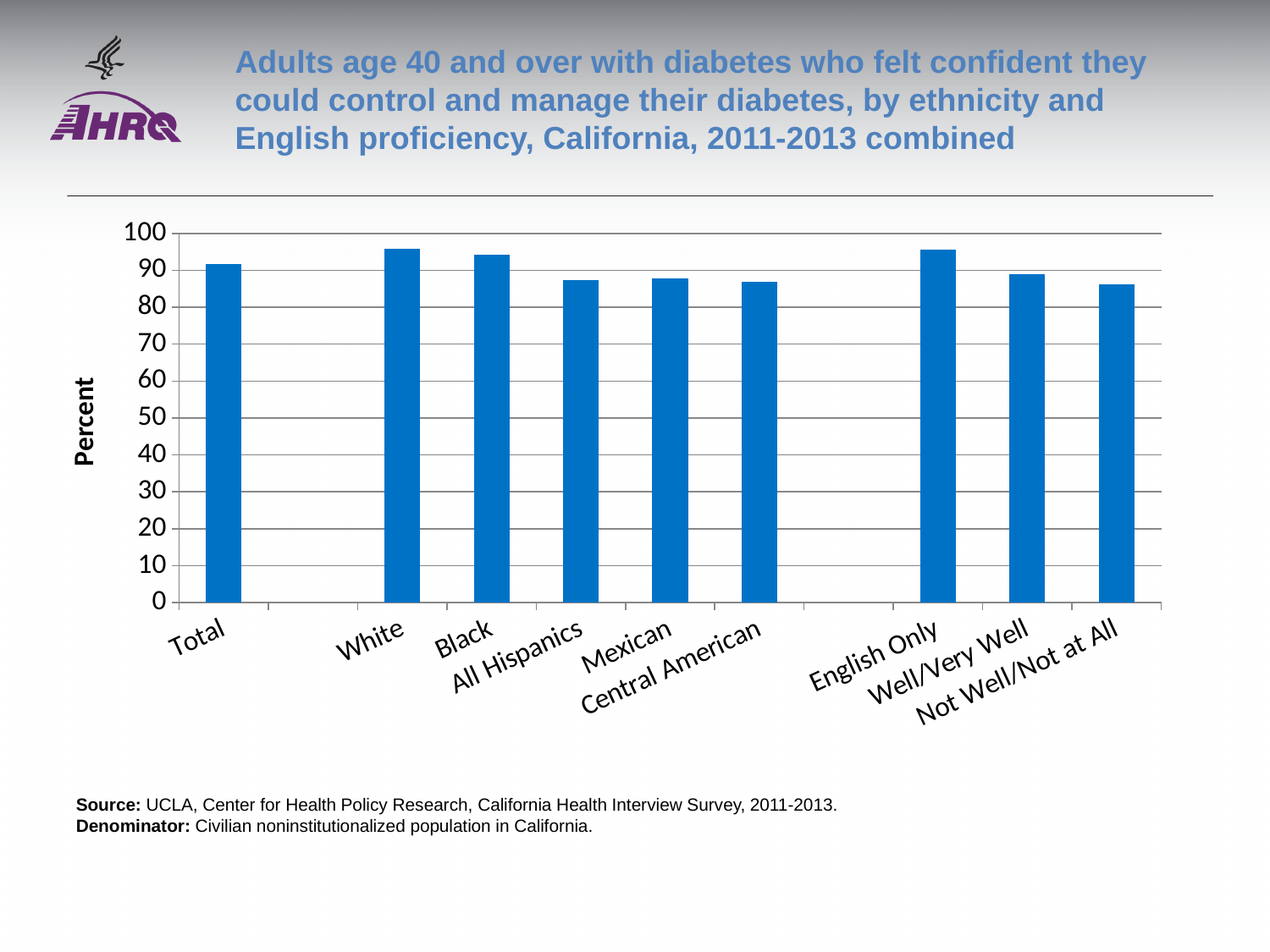
What is the label on the vertical axis of the chart? Percent Is the value for All Hispanics greater or less than 90? less Which has the larger value, Total or White? White Which has the larger value, English Only or Not Well/Not at All? English Only Is the value for Not Well/Not at All greater or less than 90? less Which has the larger value, Black or Mexican? Black How many categories (bars) are plotted in the chart? 9 Is the value for Total greater or less than 90? greater What kind of chart is shown on the slide? bar chart